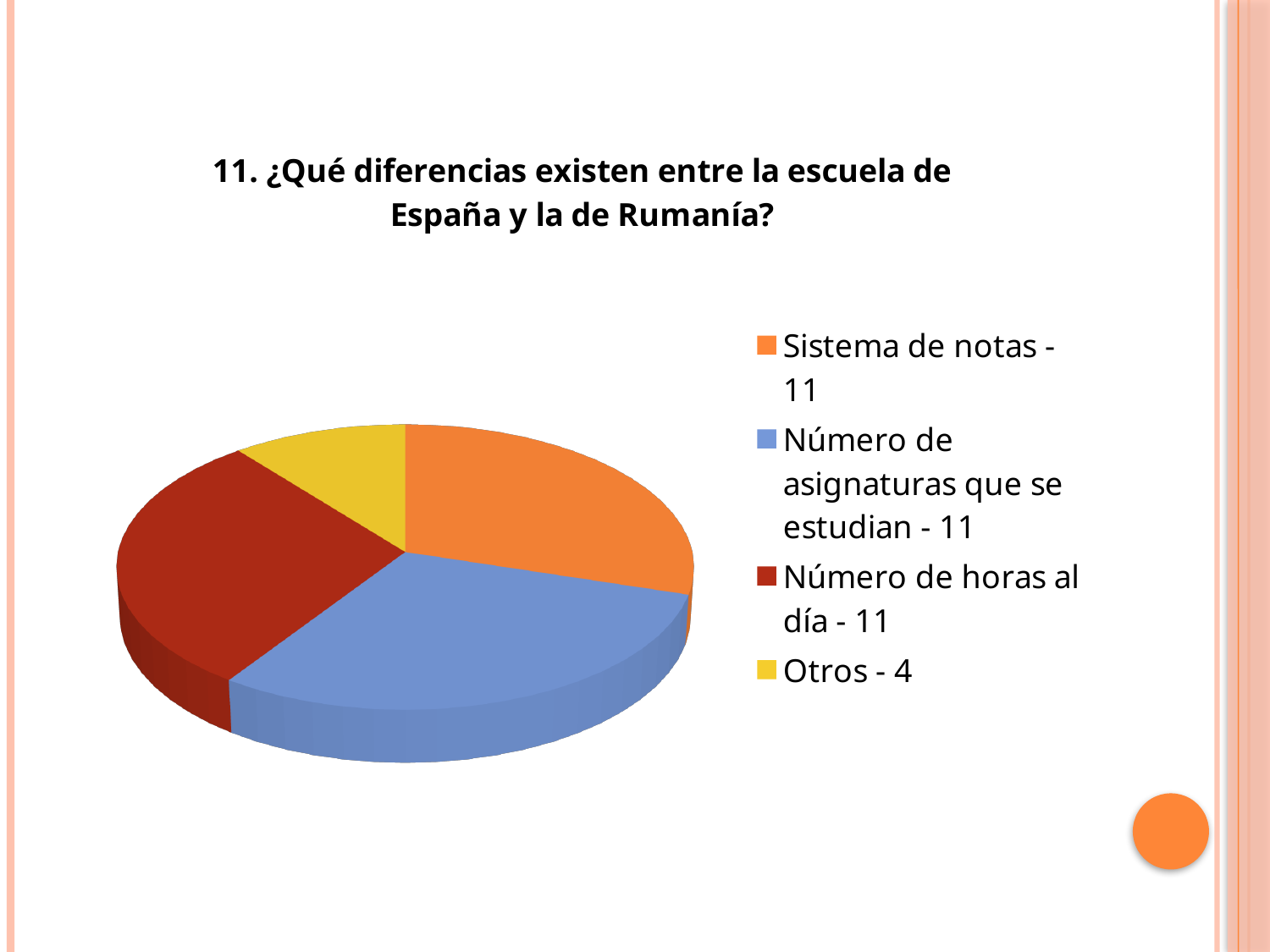
What is the total of all the values in the pie chart? 37 What kind of chart is shown on the slide? Pie chart Which category has the lowest value? Otros What is the title of the chart? 11. ¿Qué diferencias existen entre la escuela de España y la de Rumanía? What is the value for "Número de horas al día"? 11 Which is larger, the value for "Sistema de notas" or the value for "Otros"? Sistema de notas How many categories does the pie chart have? 4 What is the value for "Otros"? 4 What is the difference between the value for "Número de horas al día" and the value for "Otros"? 7 What is the value for "Sistema de notas"? 11 What is the value for "Número de asignaturas que se estudian"? 11 What colour is the slice for "Otros"? Yellow